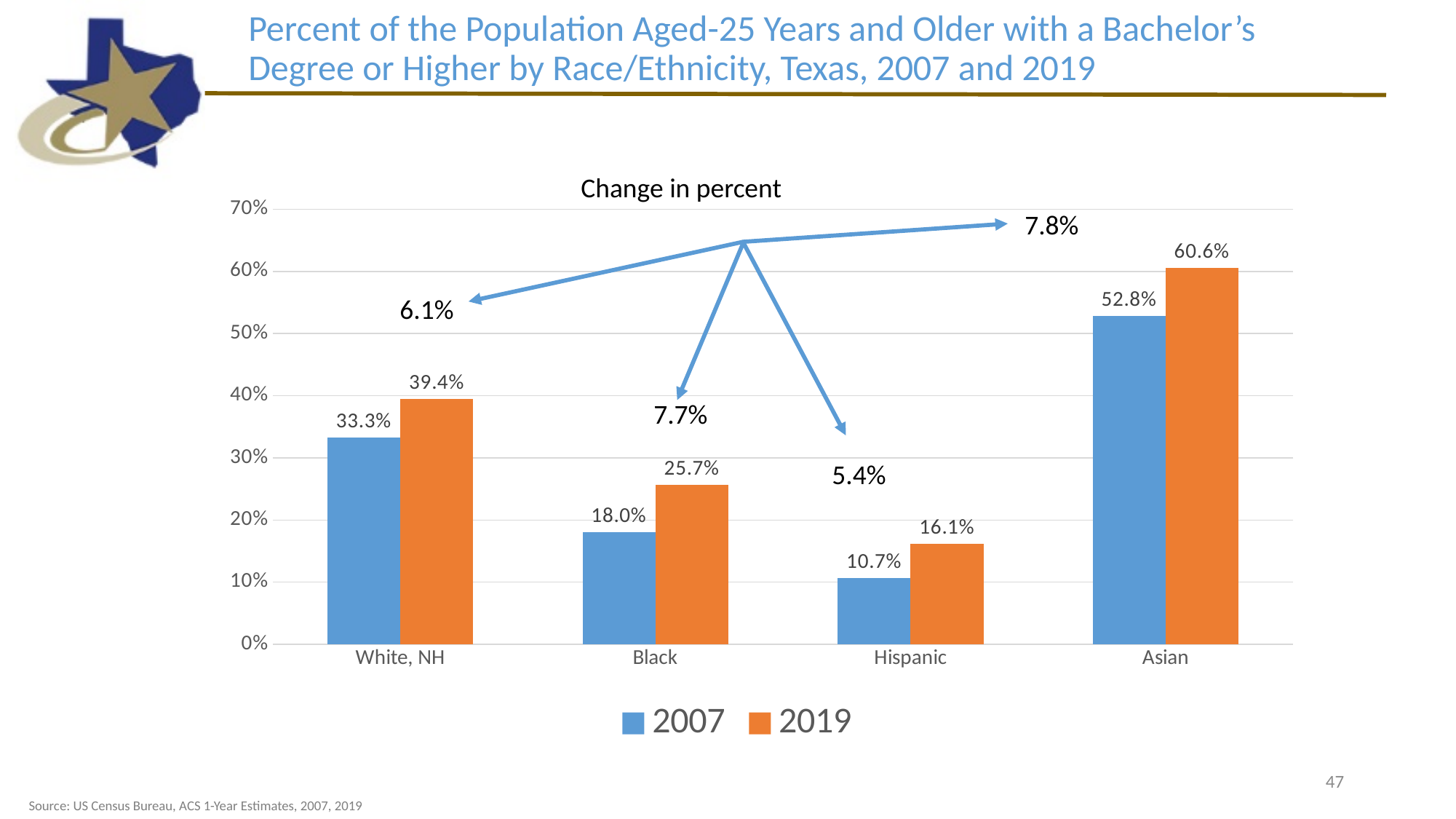
Which category has the highest 2007 value? Asian How many race/ethnicity categories are shown on the x axis? 4 Which is larger: the 2007 value for White, NH or the 2019 value for Black? 2007 value for White, NH How many series does the legend list? 2 What change in percent is annotated for Hispanic? 5.4% What is the difference between the 2019 and 2007 values for White, NH? 6.1% What kind of chart is shown on the slide? Bar chart What is the 2007 value for Hispanic? 10.7% Which category has the lowest 2019 value? Hispanic What is the difference between the 2019 values for Asian and Black? 34.9% What is the 2019 value for Black? 25.7% What is the 2019 value for Asian? 60.6%